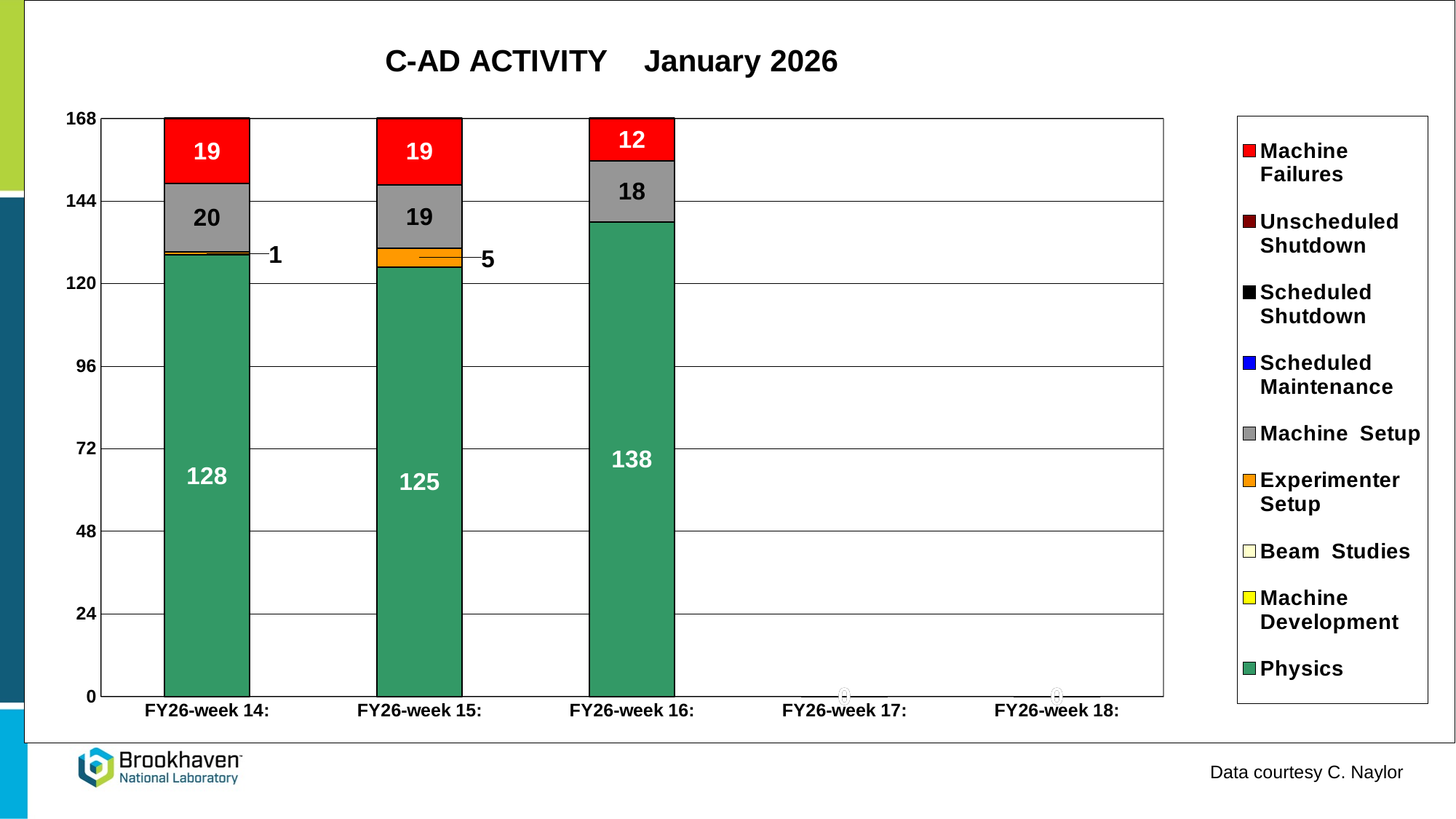
What is the Experimenter Setup value for FY26-week 15? 5 Which week has the highest Physics value? FY26-week 16 Is the Machine Setup value larger for FY26-week 14 or FY26-week 16? FY26-week 14 What is the Physics value for FY26-week 16? 138 Which week has the lowest Machine Failures value among weeks 14, 15 and 16? FY26-week 16 What is the Machine Failures value for FY26-week 14? 19 How many week categories are shown on the x axis? 5 What is the difference between the Physics values for FY26-week 16 and FY26-week 15? 13 What kind of chart is shown on the slide? Stacked bar chart What is the total of the stacked bar for FY26-week 15? 168 How many series does the legend list? 9 What is the Machine Setup value for FY26-week 16? 18